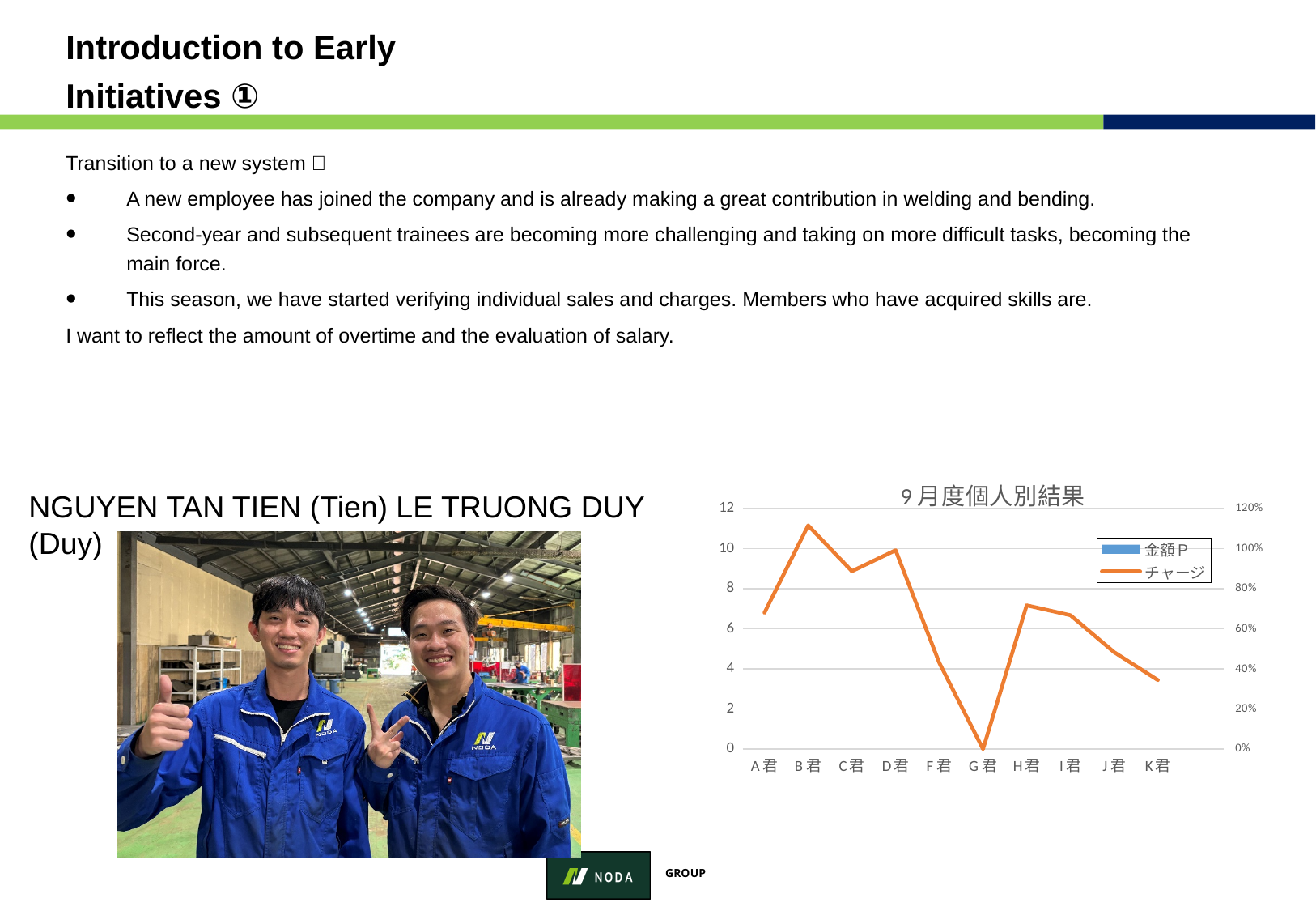
Which has the larger チャージ value, B君 or K君? B君 Does the チャージ line rise or fall from D君 to G君? fall What is the title of the chart on the slide? 9月度個人別結果 Which category has the lowest チャージ value in the 9月度個人別結果 chart? G君 What is the チャージ value for G君 in the 9月度個人別結果 chart? 0% Which category has the highest チャージ value in the 9月度個人別結果 chart? B君 What kind of chart is shown under the title 9月度個人別結果? line chart How many series does the legend of the 9月度個人別結果 chart list? 2 How many categories are shown on the x axis of the 9月度個人別結果 chart? 10